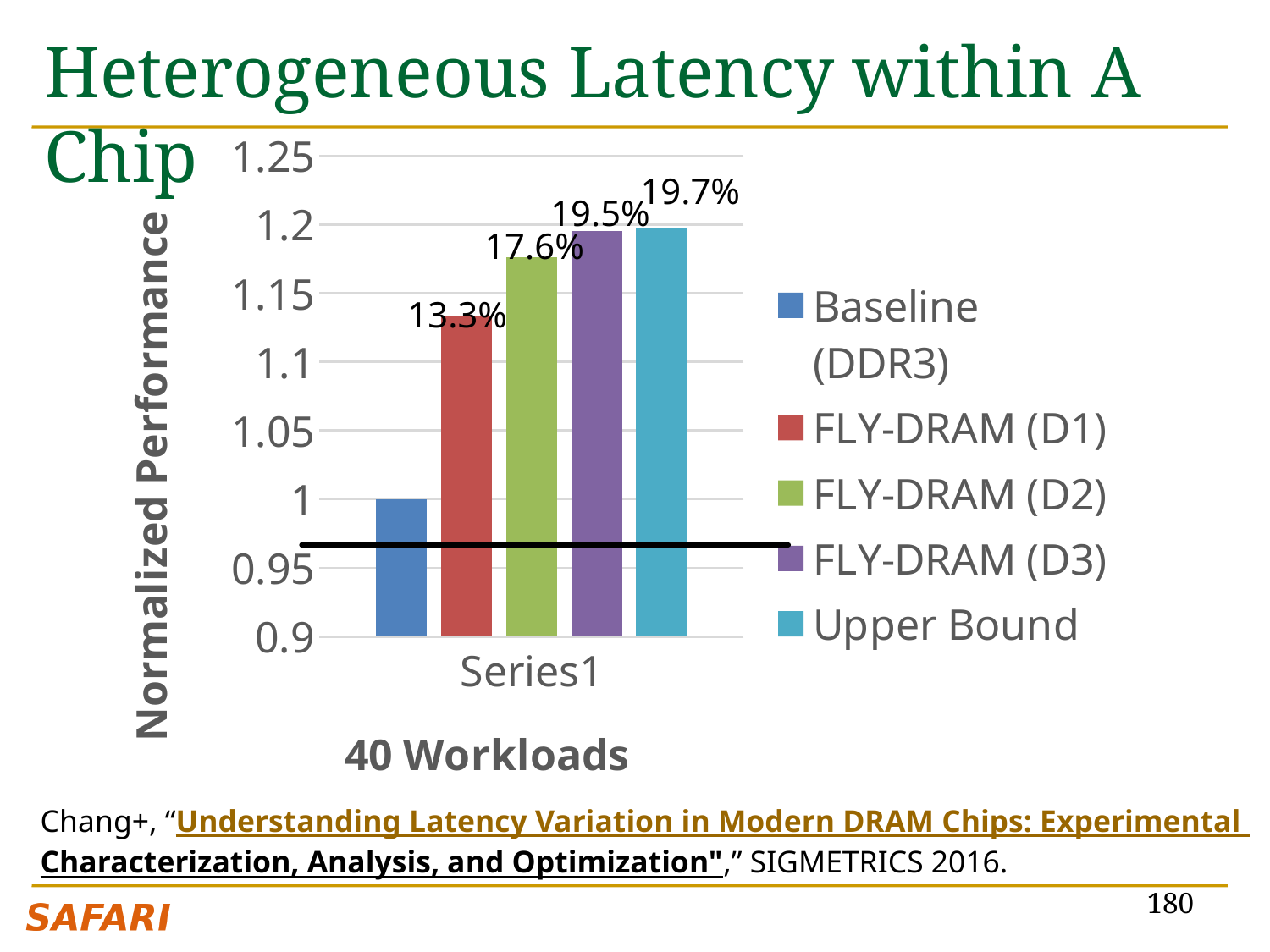
What data label is shown on the Upper Bound bar? 19.7% Which series has the shortest bar? Baseline (DDR3) What is the title of the vertical axis? Normalized Performance What data label is shown on the FLY-DRAM (D1) bar? 13.3% Is the normalized performance of FLY-DRAM (D1) greater or less than 1.1? greater What is the difference between the labelled percentages of Upper Bound and FLY-DRAM (D1)? 6.4% What normalized performance value does the Baseline (DDR3) bar reach? 1 What data label is shown on the FLY-DRAM (D3) bar? 19.5% What kind of chart is shown on the slide? bar chart Which series has the tallest bar? Upper Bound How many series does the legend list? 5 What data label is shown on the FLY-DRAM (D2) bar? 17.6%